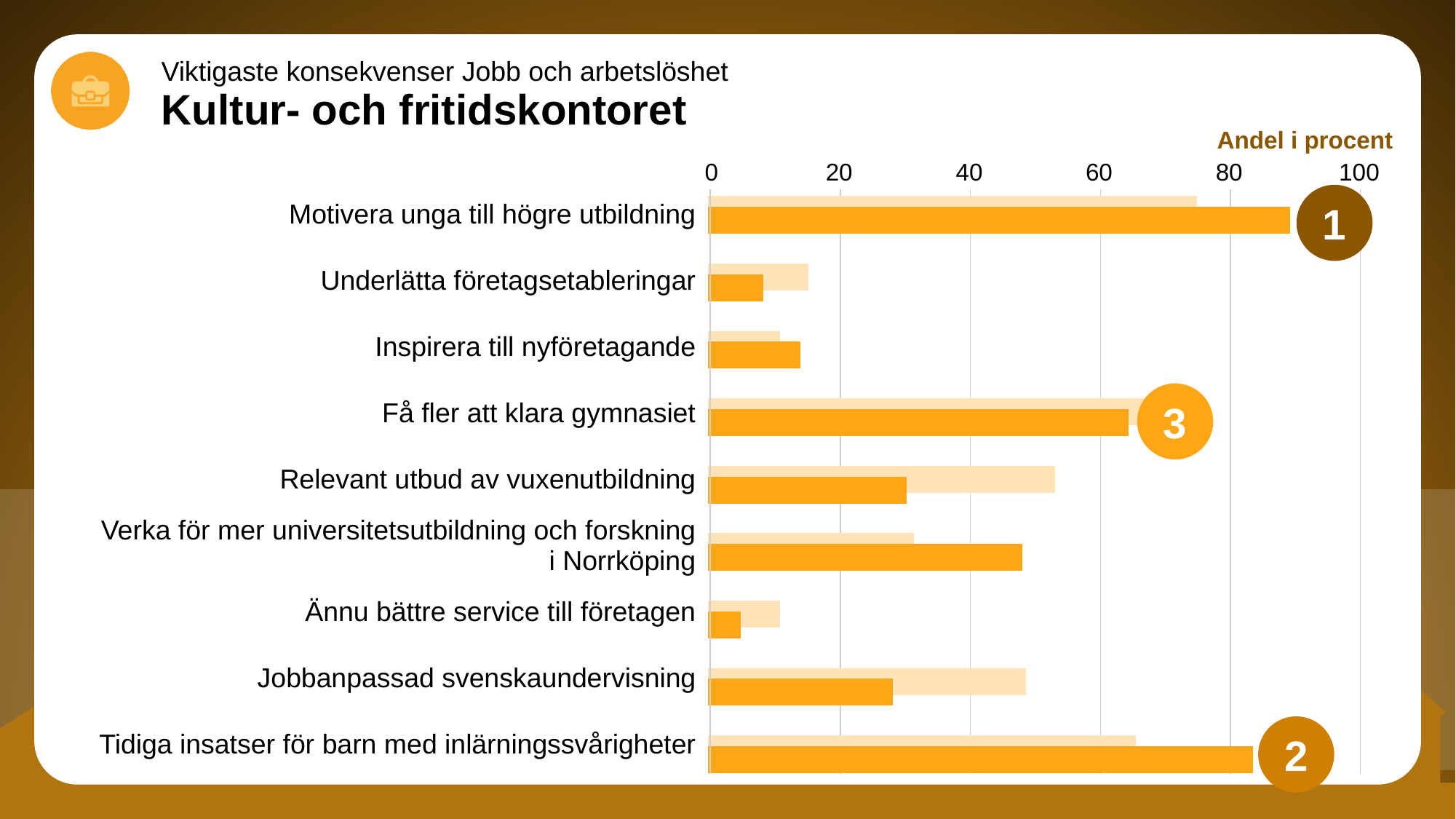
Which category has the longest dark orange bar? Motivera unga till högre utbildning Which has the larger dark orange bar: Verka för mer universitetsutbildning och forskning i Norrköping or Jobbanpassad svenskaundervisning? Verka för mer universitetsutbildning och forskning i Norrköping Is the dark orange bar for Tidiga insatser för barn med inlärningssvårigheter greater or less than 60? greater What kind of chart is shown on the slide? bar chart What is the label shown above the horizontal axis of the chart? Andel i procent Which has the larger light orange bar: Relevant utbud av vuxenutbildning or Verka för mer universitetsutbildning och forskning i Norrköping? Relevant utbud av vuxenutbildning How many categories are listed on the chart? 9 Is the dark orange bar for Relevant utbud av vuxenutbildning greater or less than 40? less Is the dark orange bar for Få fler att klara gymnasiet greater or less than 60? greater Which category has the shortest dark orange bar? Ännu bättre service till företagen